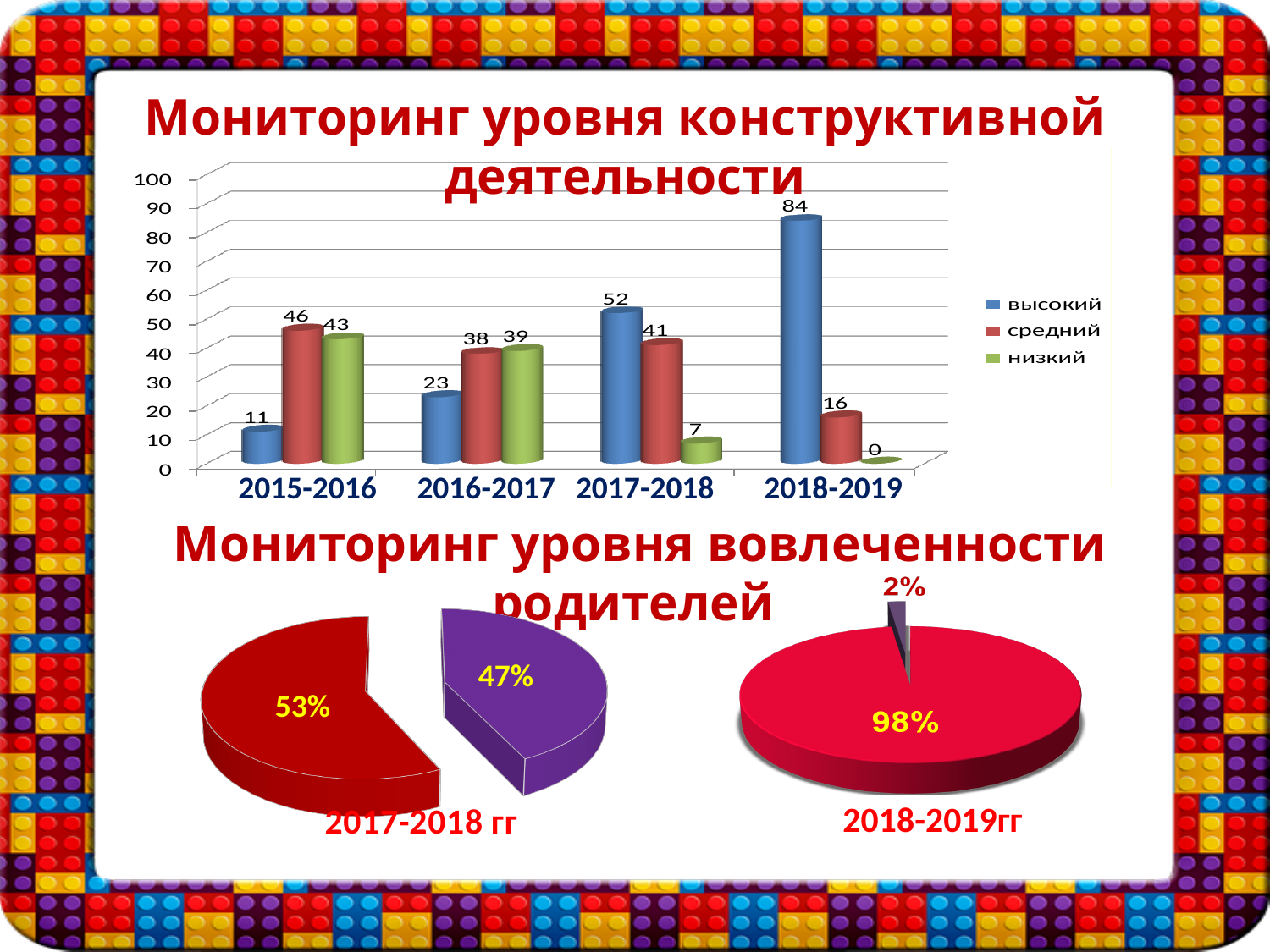
In the bar chart 'Мониторинг уровня конструктивной деятельности', which year has the lowest value for низкий? 2018-2019 In the bar chart 'Мониторинг уровня конструктивной деятельности', does the высокий series rise or fall from 2015-2016 to 2018-2019? rise In the bar chart 'Мониторинг уровня конструктивной деятельности', which is larger in 2016-2017: средний or низкий? низкий In the bar chart 'Мониторинг уровня конструктивной деятельности', how many year categories are shown on the x axis? 4 In the bar chart 'Мониторинг уровня конструктивной деятельности', how many series does the legend list? 3 In the pie chart labelled '2018-2019гг', what share does the small purple slice have? 2% In the bar chart 'Мониторинг уровня конструктивной деятельности', what is the difference between the высокий values for 2018-2019 and 2017-2018? 32 In the pie chart labelled '2017-2018 гг', what share does the red slice have? 53% In the bar chart 'Мониторинг уровня конструктивной деятельности', what is the value for средний in 2015-2016? 46 In the bar chart 'Мониторинг уровня конструктивной деятельности', what is the value for низкий in 2017-2018? 7 In the bar chart 'Мониторинг уровня конструктивной деятельности', which year has the highest value for высокий? 2018-2019 In the bar chart 'Мониторинг уровня конструктивной деятельности', what is the value for высокий in 2018-2019? 84